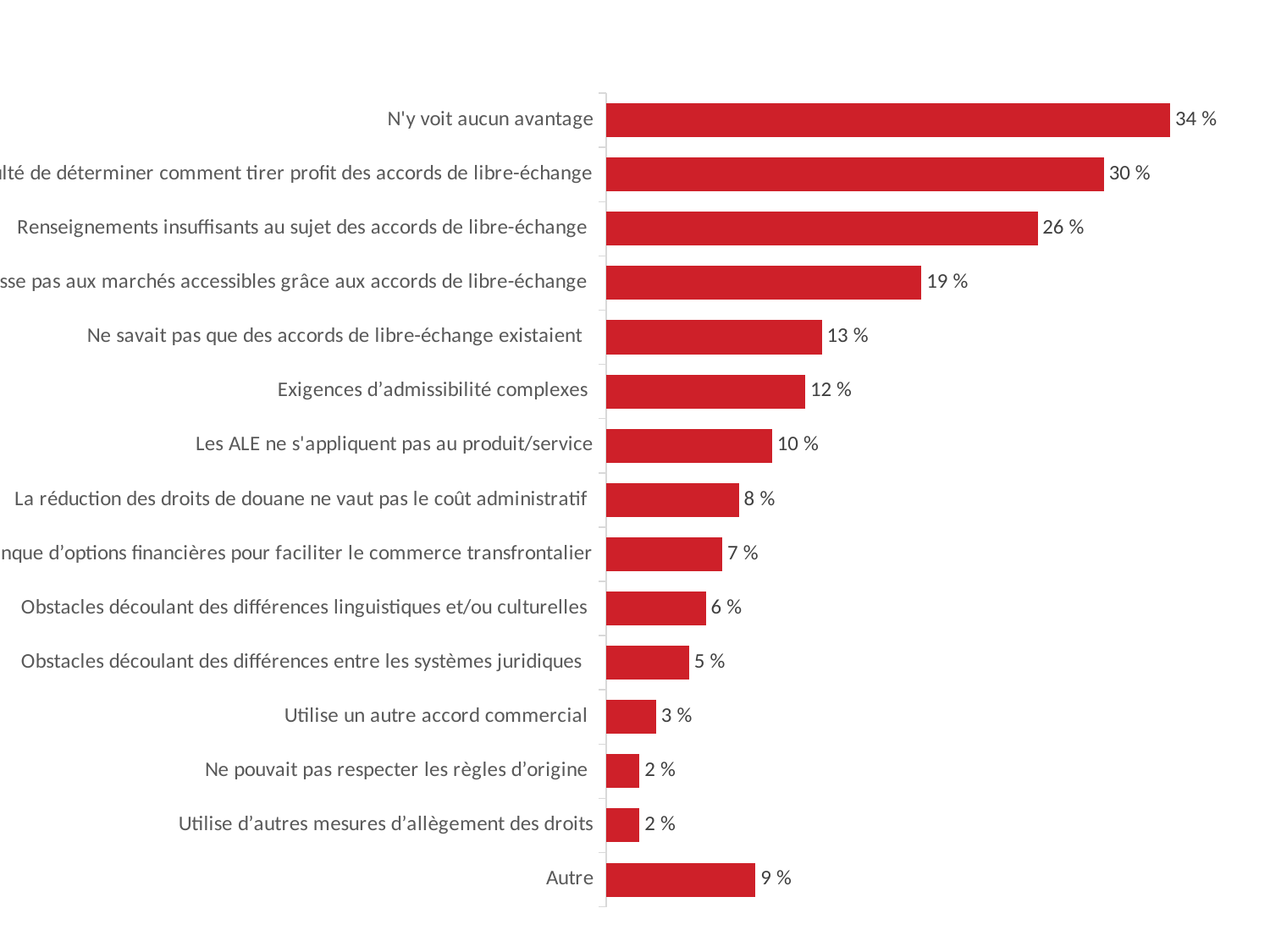
Which category has the highest value? N'y voit aucun avantage What is the value for "Renseignements insuffisants au sujet des accords de libre-échange"? 26 % How many categories are shown in the chart? 15 What is the value for "N'y voit aucun avantage"? 34 % What is the value for "Utilise un autre accord commercial"? 3 % What is the value for "Autre"? 9 % What is the difference between the values for "N'y voit aucun avantage" and "Renseignements insuffisants au sujet des accords de libre-échange"? 8 % Which is larger: the value for "Les ALE ne s'appliquent pas au produit/service" or the value for "Autre"? Les ALE ne s'appliquent pas au produit/service What type of chart is shown on the slide? bar chart What is the value for "Ne savait pas que des accords de libre-échange existaient"? 13 % What is the value for "Exigences d'admissibilité complexes"? 12 % What is the lowest value shown in the chart? 2 %